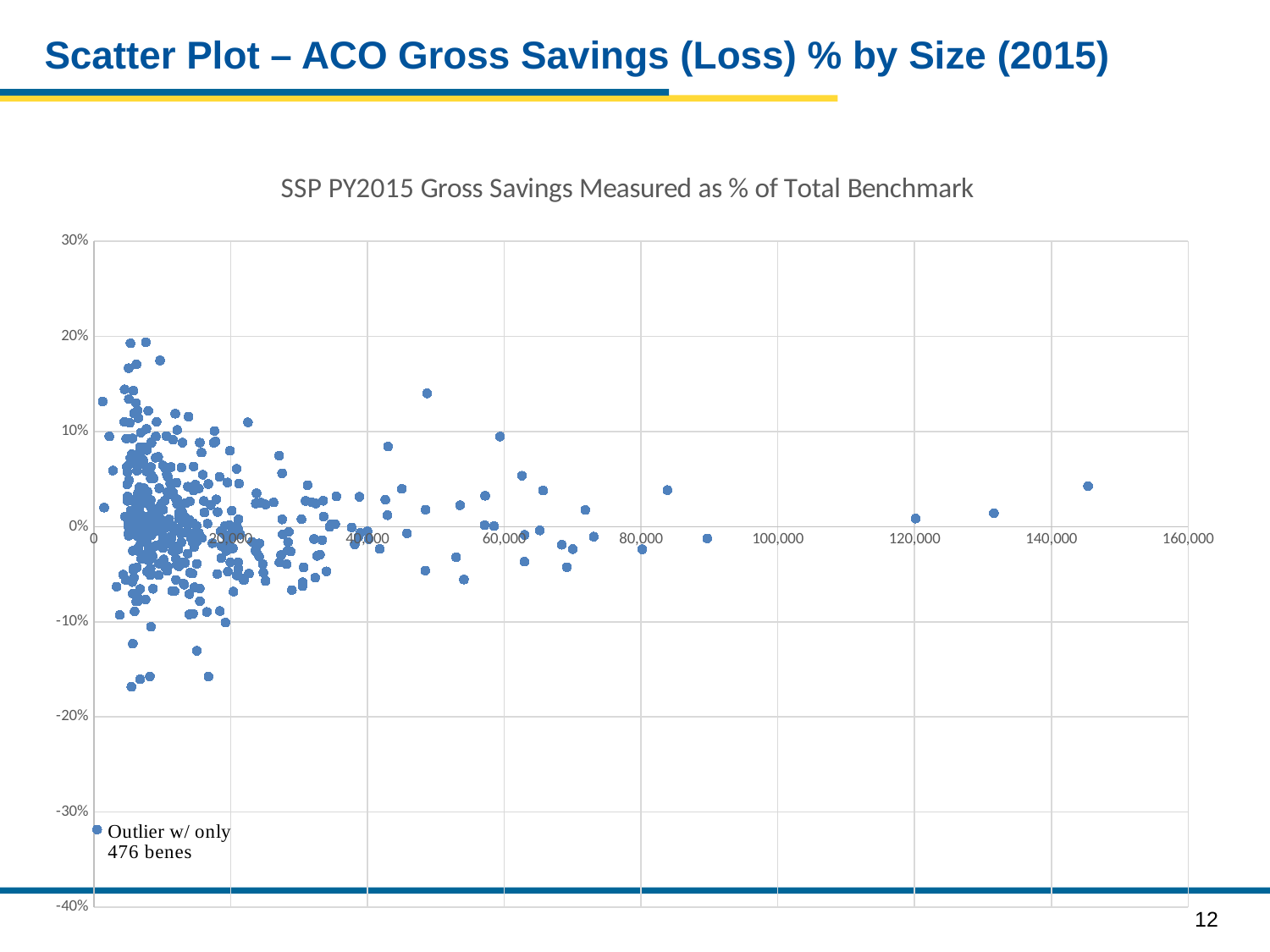
Which has the higher gross savings value: the outlier point labelled "Outlier w/ only 476 benes" or the rightmost point near 145,000? The rightmost point near 145,000 Is the value for the highest point on the chart greater or less than 10%? greater What does the annotation next to the lowest point on the chart say? Outlier w/ only 476 benes Is the value for the rightmost point on the chart (near 145,000 on the x axis) greater or less than 0%? greater Is the value for the outlier point labelled "Outlier w/ only 476 benes" greater or less than -30%? less What is the title of the chart? SSP PY2015 Gross Savings Measured as % of Total Benchmark What kind of chart is shown on the slide? Scatter plot